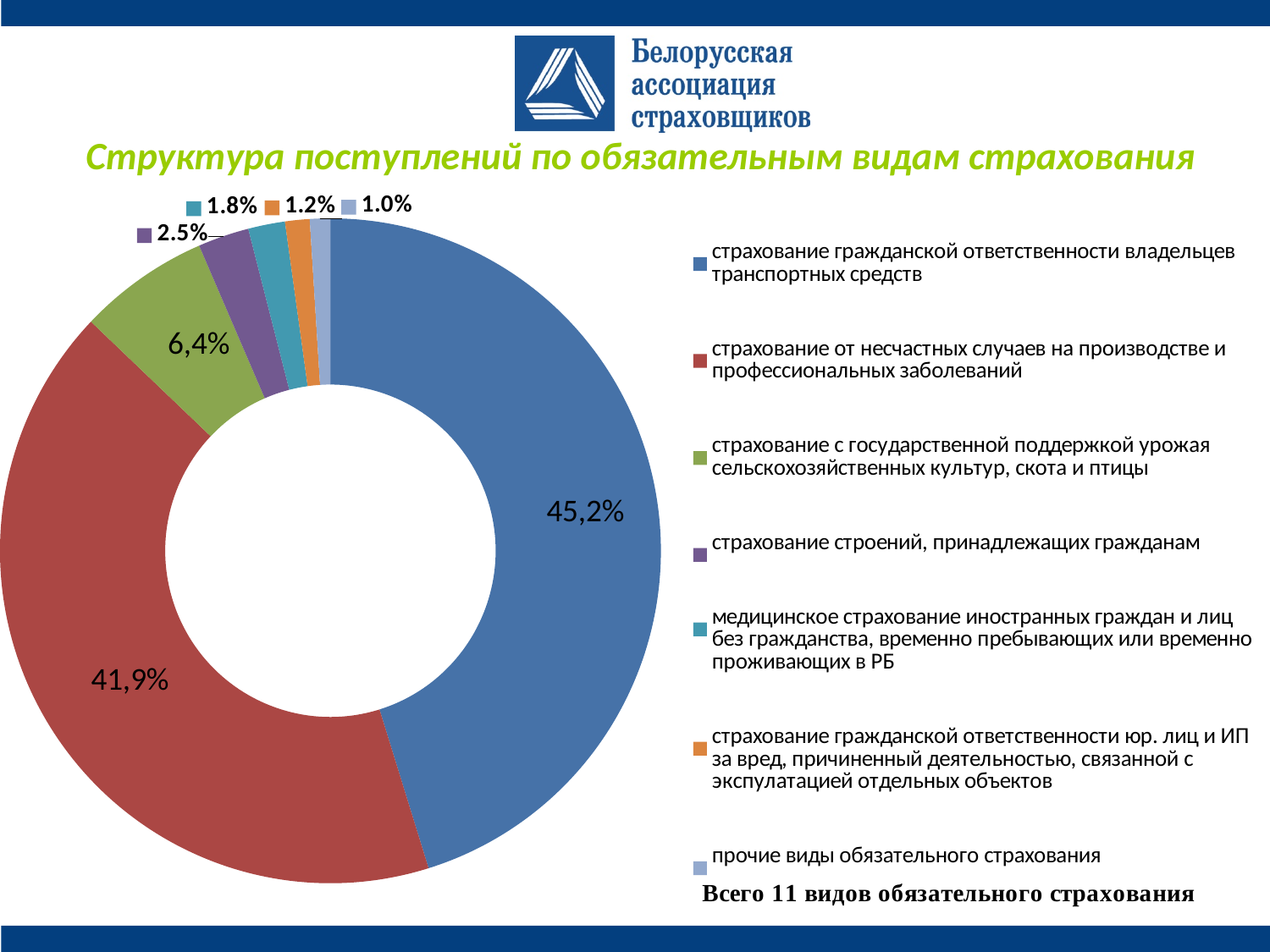
What share is shown for страхование от несчастных случаев на производстве и профессиональных заболеваний? 41,9% What share is shown for страхование с государственной поддержкой урожая сельскохозяйственных культур, скота и птицы? 6,4% What is the title of the chart? Структура поступлений по обязательным видам страхования What share is shown for прочие виды обязательного страхования? 1.0% What share of the chart is labelled for страхование гражданской ответственности владельцев транспортных средств? 45,2% How many slices does the chart have? 7 What is the difference between the shares for страхование гражданской ответственности владельцев транспортных средств and страхование от несчастных случаев на производстве и профессиональных заболеваний? 3,3% Which category has the smallest share of the chart? прочие виды обязательного страхования Which is larger: the share for страхование строений, принадлежащих гражданам or the share for медицинское страхование иностранных граждан? страхование строений, принадлежащих гражданам What kind of chart is shown on the slide? doughnut chart What share is shown for страхование строений, принадлежащих гражданам? 2.5% Which category has the largest share of the chart? страхование гражданской ответственности владельцев транспортных средств